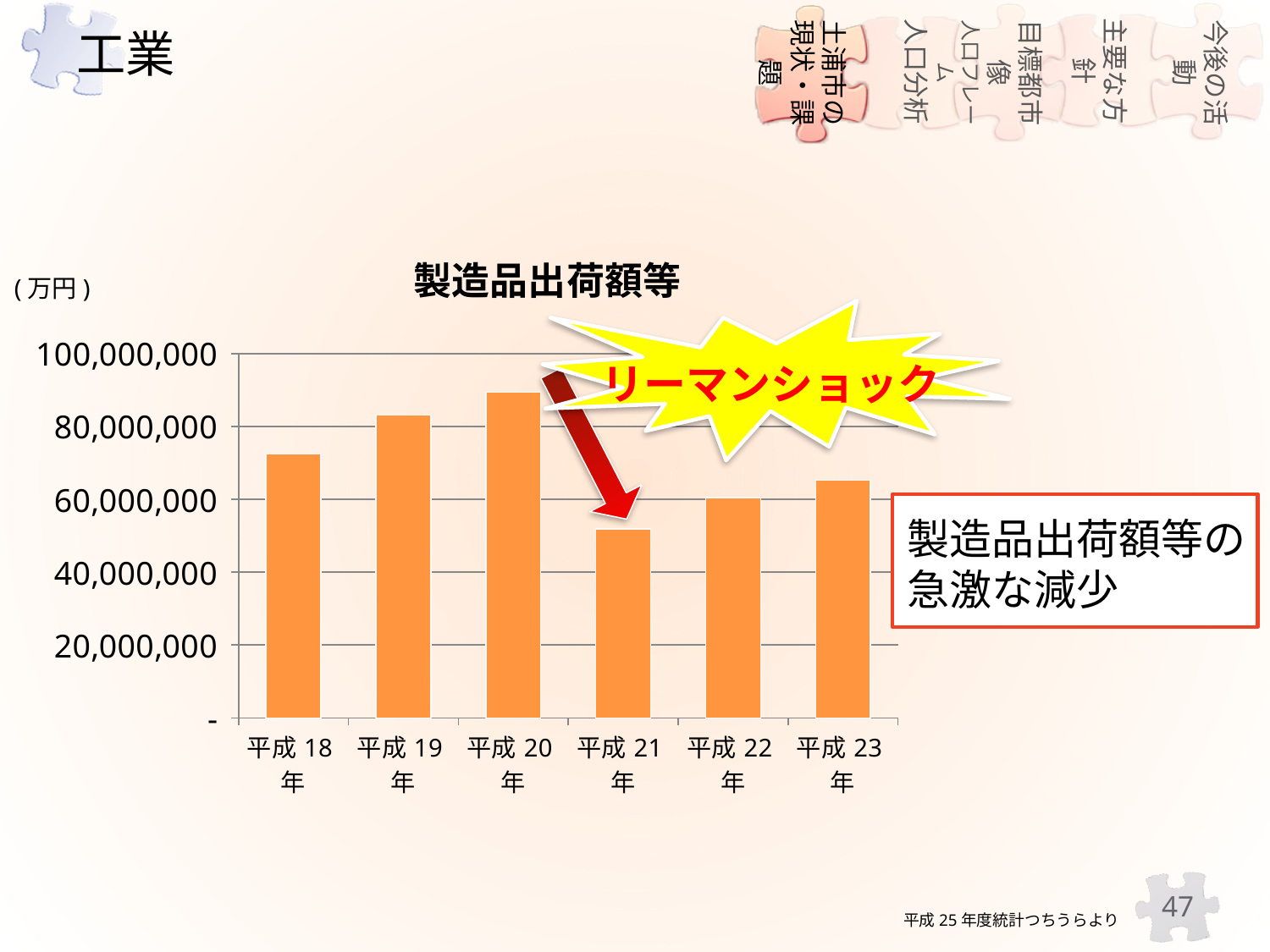
Is the value for 平成20年 greater or less than 80,000,000? greater What kind of chart is shown on the slide? bar chart Is the value for 平成21年 greater or less than 60,000,000? less Does the value rise or fall from 平成20年 to 平成21年? fall Which year has the highest value in the chart? 平成20年 Is the value for 平成23年 greater or less than 60,000,000? greater What unit is shown for the vertical axis of the chart? 万円 Which is larger, the value for 平成20年 or the value for 平成21年? 平成20年 Which year has the lowest value in the chart? 平成21年 How many years (categories) are plotted in the chart? 6 What is the title of the chart? 製造品出荷額等